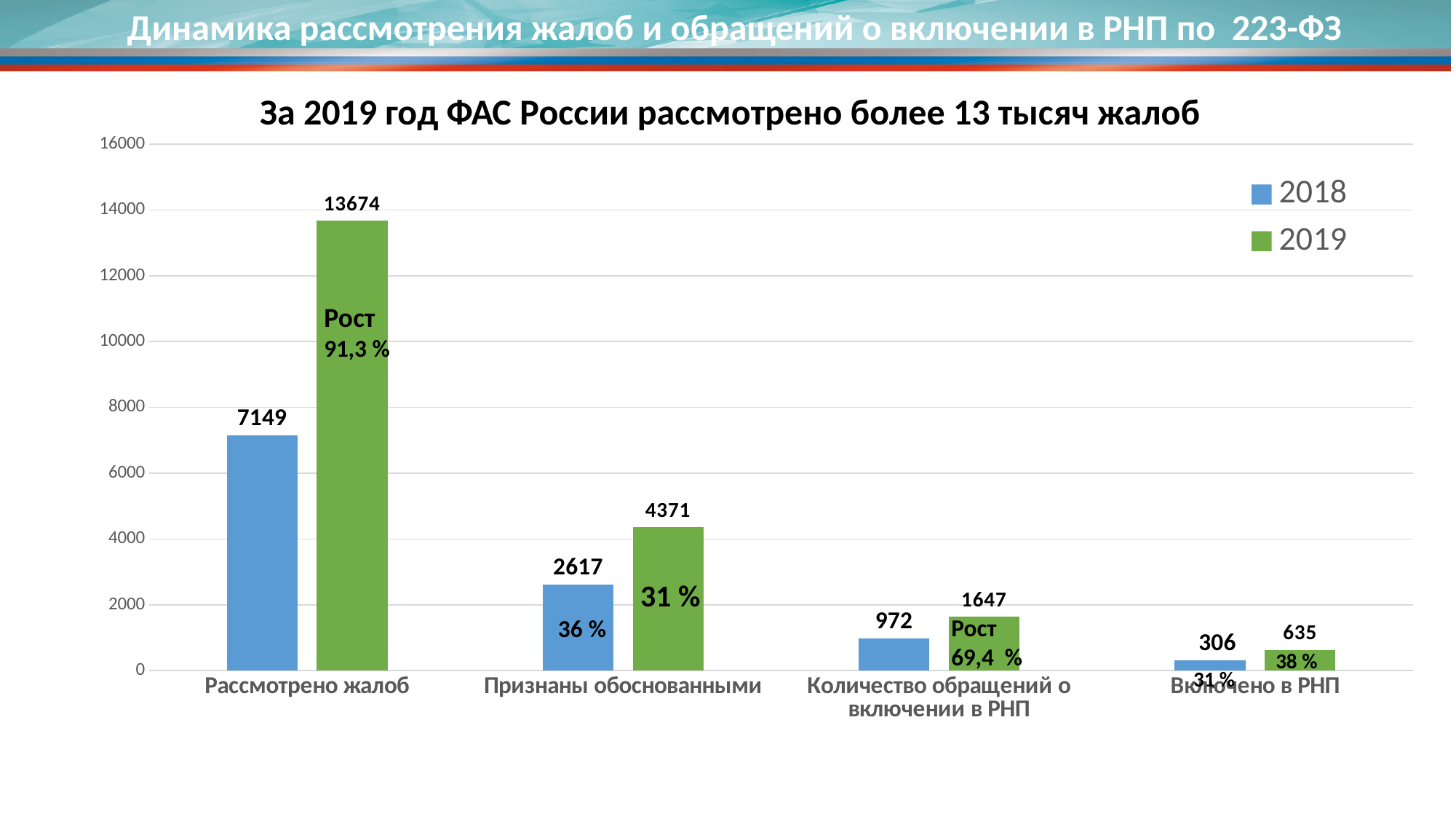
What is the 2019 value for Рассмотрено жалоб? 13674 What is the difference between the 2019 and 2018 values for Рассмотрено жалоб? 6525 What is the 2018 value for Признаны обоснованными? 2617 How many series does the legend list? 2 What is the 2019 value for Количество обращений о включении в РНП? 1647 Which category has the highest 2019 value? Рассмотрено жалоб What growth percentage is printed on the 2019 bar for Рассмотрено жалоб? 91,3 % How many categories are shown on the x axis? 4 What kind of chart is shown on the slide? Bar chart Which is larger: the 2019 value for Признаны обоснованными or the 2018 value for Рассмотрено жалоб? 2018 value for Рассмотрено жалоб Which category has the lowest 2018 value? Включено в РНП What is the 2018 value for Включено в РНП? 306